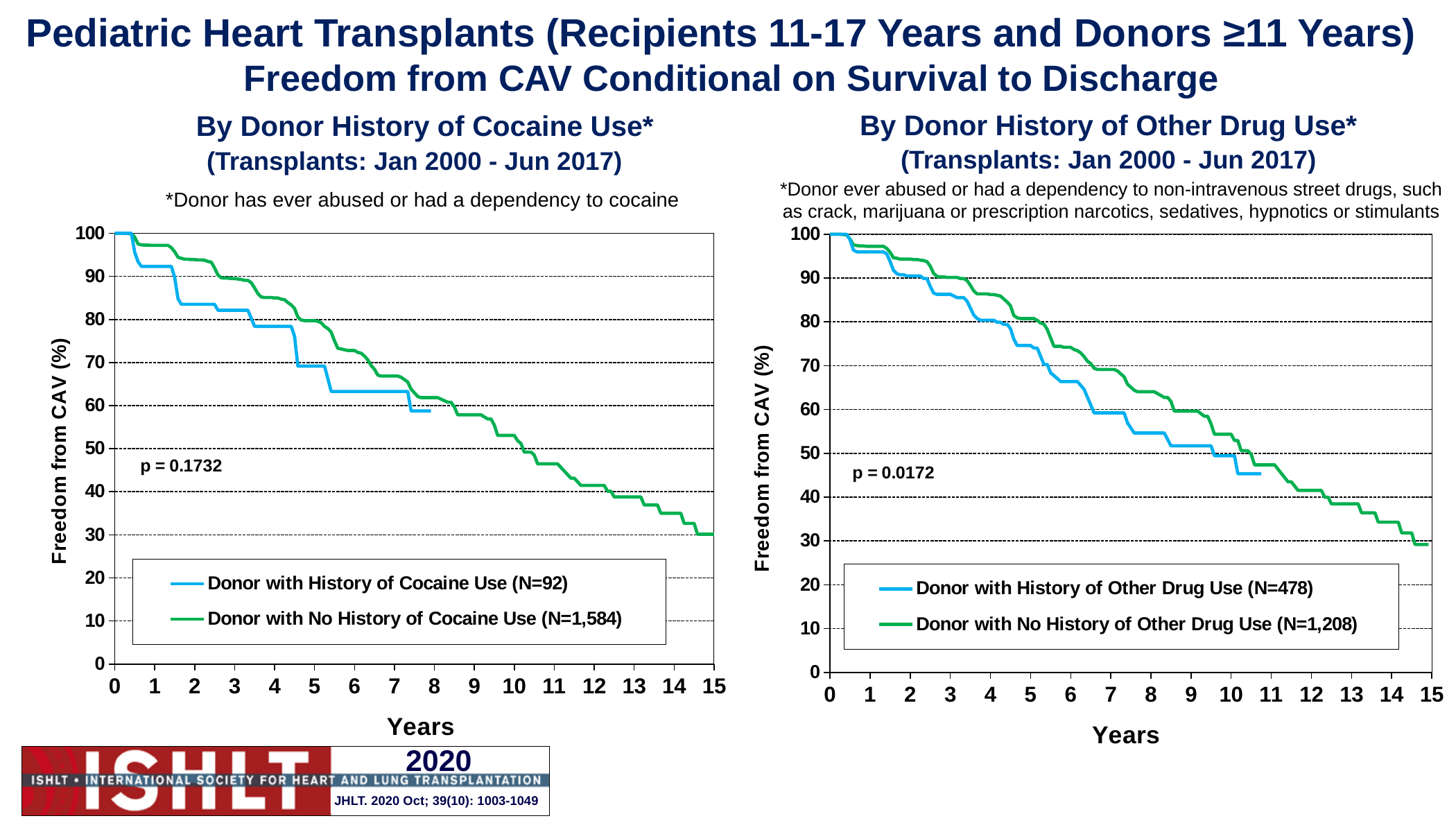
In the right chart, 'By Donor History of Other Drug Use', what is the N for donors with no history of other drug use according to the legend? N=1,208 In the right chart, 'By Donor History of Other Drug Use', do the lines rise or fall as years increase? Fall In the left chart, 'By Donor History of Cocaine Use', which line is higher at 5 years: the blue 'History of Cocaine Use' line or the green 'No History of Cocaine Use' line? Green (No History of Cocaine Use) In the right chart, 'By Donor History of Other Drug Use', is the value of the blue 'History of Other Drug Use' line at 8 years greater or less than 50? greater In the left chart, 'By Donor History of Cocaine Use', what is the N for donors with a history of cocaine use according to the legend? N=92 In the right chart, 'By Donor History of Other Drug Use', is the value of the green 'No History of Other Drug Use' line at 14 years greater or less than 40? less What is the y-axis label of the left chart, 'By Donor History of Cocaine Use'? Freedom from CAV (%) What kind of chart is the left chart, 'By Donor History of Cocaine Use'? Line chart In the left chart, 'By Donor History of Cocaine Use', what is the p-value shown? p = 0.1732 How many series does the legend of the right chart, 'By Donor History of Other Drug Use', list? 2 In the left chart, 'By Donor History of Cocaine Use', is the value of the green 'No History of Cocaine Use' line at 12 years greater or less than 40? greater In the right chart, 'By Donor History of Other Drug Use', what is the p-value shown? p = 0.0172